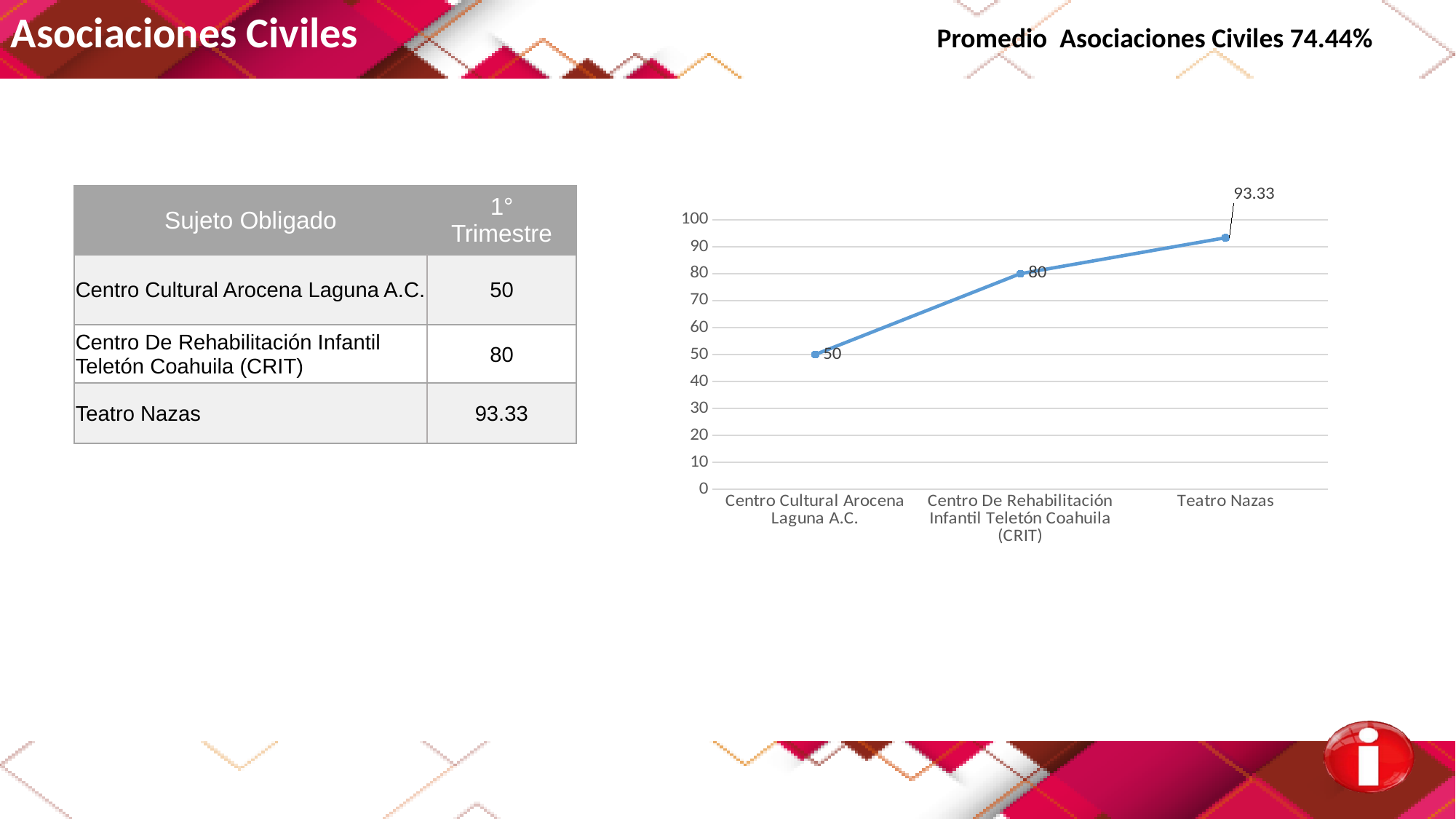
What is the value for Centro Cultural Arocena Laguna A.C.? 50 Do the values rise or fall from left to right along the x axis? rise Which is larger, the value for Centro De Rehabilitación Infantil Teletón Coahuila (CRIT) or the value for Teatro Nazas? Teatro Nazas How many categories are plotted on the chart? 3 Is the value for Teatro Nazas greater or less than 90? greater What is the difference between the values for Teatro Nazas and Centro Cultural Arocena Laguna A.C.? 43.33 What is the value for Teatro Nazas? 93.33 What is the difference between the values for Centro De Rehabilitación Infantil Teletón Coahuila (CRIT) and Centro Cultural Arocena Laguna A.C.? 30 Which category has the highest value? Teatro Nazas What kind of chart is shown on the slide? line chart What is the value for Centro De Rehabilitación Infantil Teletón Coahuila (CRIT)? 80 Which category has the lowest value? Centro Cultural Arocena Laguna A.C.